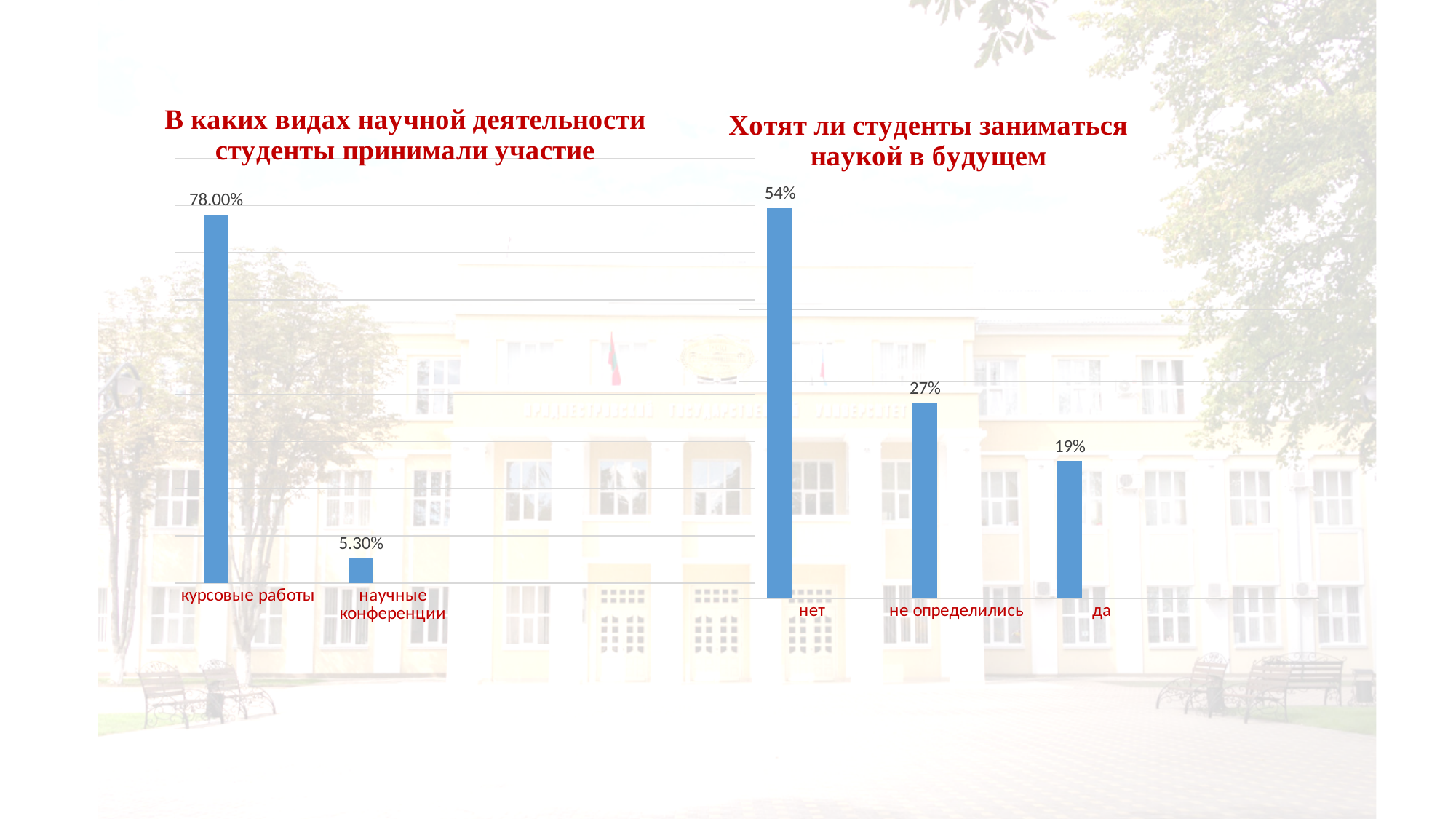
In the left chart 'В каких видах научной деятельности студенты принимали участие', what is the value for 'научные конференции'? 5.30% In the right chart 'Хотят ли студенты заниматься наукой в будущем', what is the value for 'не определились'? 27% What type of chart is the right chart 'Хотят ли студенты заниматься наукой в будущем'? bar chart In the left chart 'В каких видах научной деятельности студенты принимали участие', which category has the highest value? курсовые работы In the right chart 'Хотят ли студенты заниматься наукой в будущем', what is the value for 'нет'? 54% In the right chart 'Хотят ли студенты заниматься наукой в будущем', what is the value for 'да'? 19% In the left chart 'В каких видах научной деятельности студенты принимали участие', what is the difference between 'курсовые работы' and 'научные конференции'? 72.70% In the right chart 'Хотят ли студенты заниматься наукой в будущем', what is the difference between 'нет' and 'да'? 35% In the left chart 'В каких видах научной деятельности студенты принимали участие', what is the value for 'курсовые работы'? 78.00% In the right chart 'Хотят ли студенты заниматься наукой в будущем', which is larger: 'не определились' or 'да'? не определились In the right chart 'Хотят ли студенты заниматься наукой в будущем', which category has the lowest value? да In the left chart 'В каких видах научной деятельности студенты принимали участие', how many categories are shown? 2